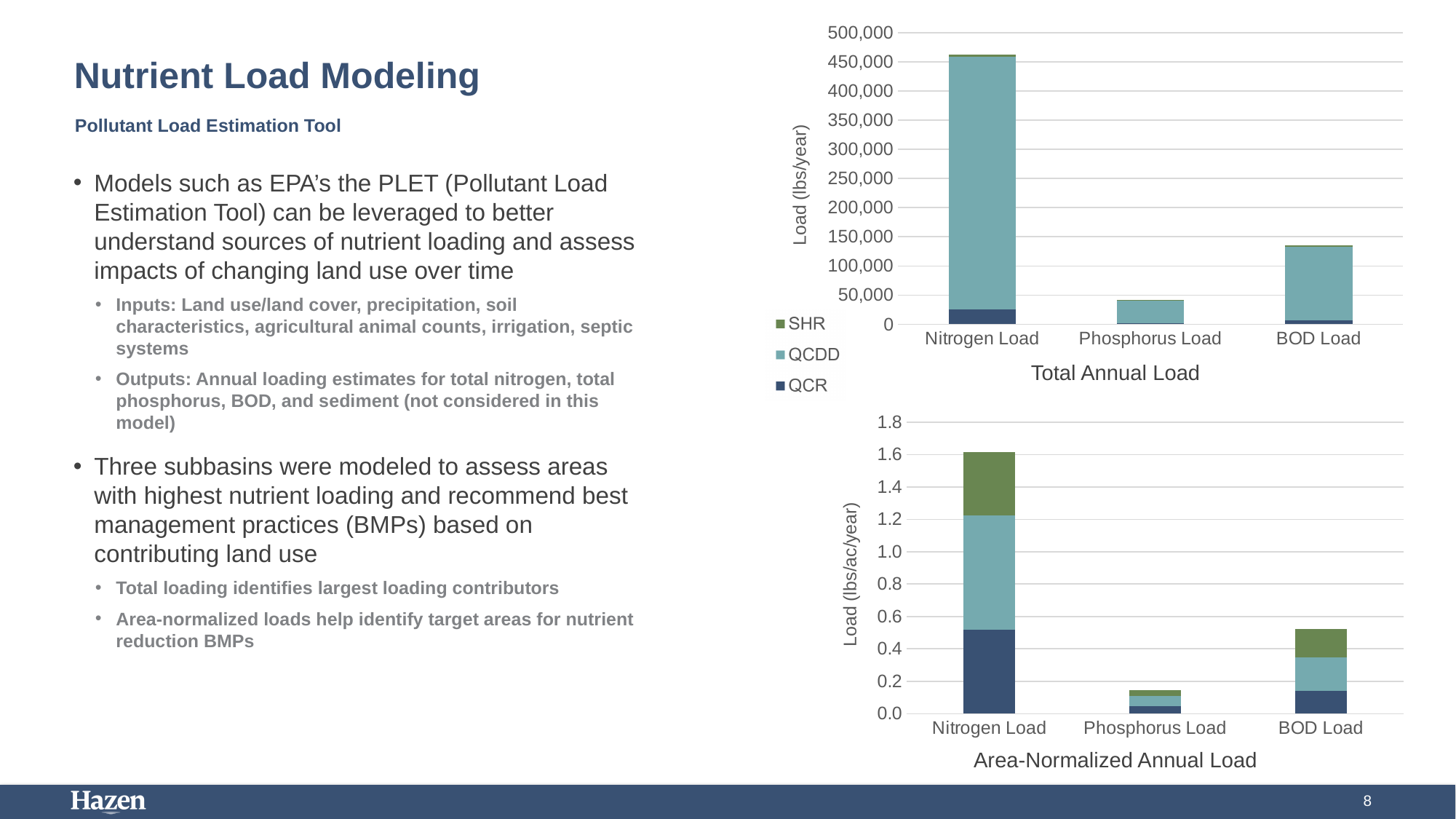
In the "Total Annual Load" chart, which category has the lowest total load? Phosphorus Load How many categories are shown on the x axis of the "Area-Normalized Annual Load" chart? 3 What kind of chart is the "Total Annual Load" chart? Stacked bar chart How many series does the legend list for the charts on this slide? 3 In the "Total Annual Load" chart, is the total for Nitrogen Load greater or less than 400,000? greater In the "Area-Normalized Annual Load" chart, is the total for BOD Load greater or less than 0.4? greater What is the y-axis label of the "Area-Normalized Annual Load" chart? Load (lbs/ac/year) In the "Total Annual Load" chart, is the total for Phosphorus Load greater or less than 50,000? less In the "Area-Normalized Annual Load" chart, which is larger, the total for Phosphorus Load or the total for BOD Load? BOD Load In the "Total Annual Load" chart, which category has the highest total load? Nitrogen Load In the "Area-Normalized Annual Load" chart, which category has the highest total? Nitrogen Load